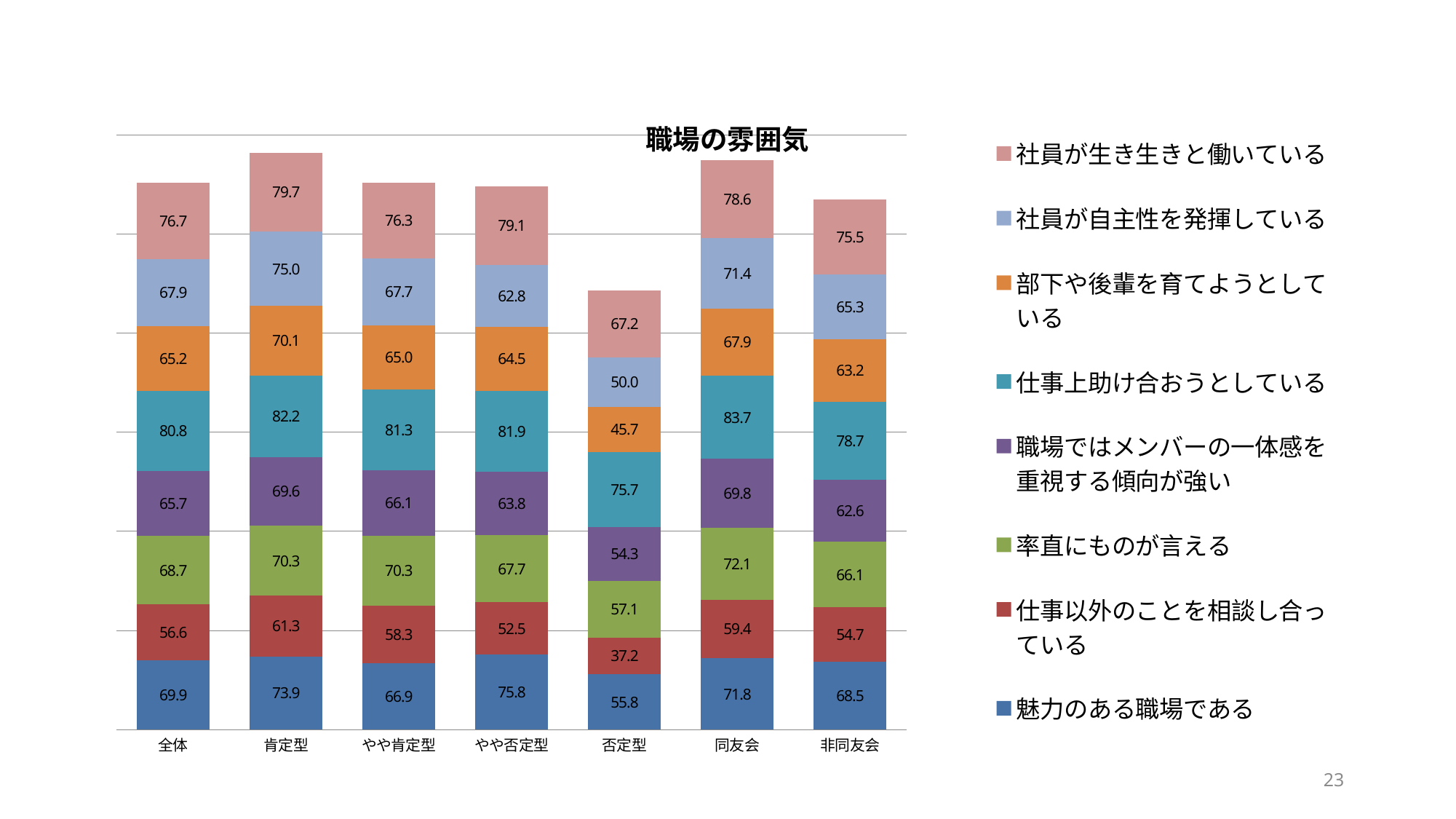
What is the total of the stacked bar for 否定型? 443.0 How many series does the legend list? 8 What is the difference between 肯定型 and 否定型 for 部下や後輩を育てようとしている? 24.4 How many categories are shown along the x axis? 7 Which is larger for 率直にものが言える: 同友会 or 非同友会? 同友会 What is the value of 仕事以外のことを相談し合っている for 否定型? 37.2 Which category has the lowest value for 社員が自主性を発揮している? 否定型 What is the value of 魅力のある職場である for 肯定型? 73.9 What kind of chart is shown on the slide? stacked bar chart What is the value of 社員が生き生きと働いている for 同友会? 78.6 Which category has the highest value for 仕事上助け合おうとしている? 同友会 What is the title of the chart? 職場の雰囲気